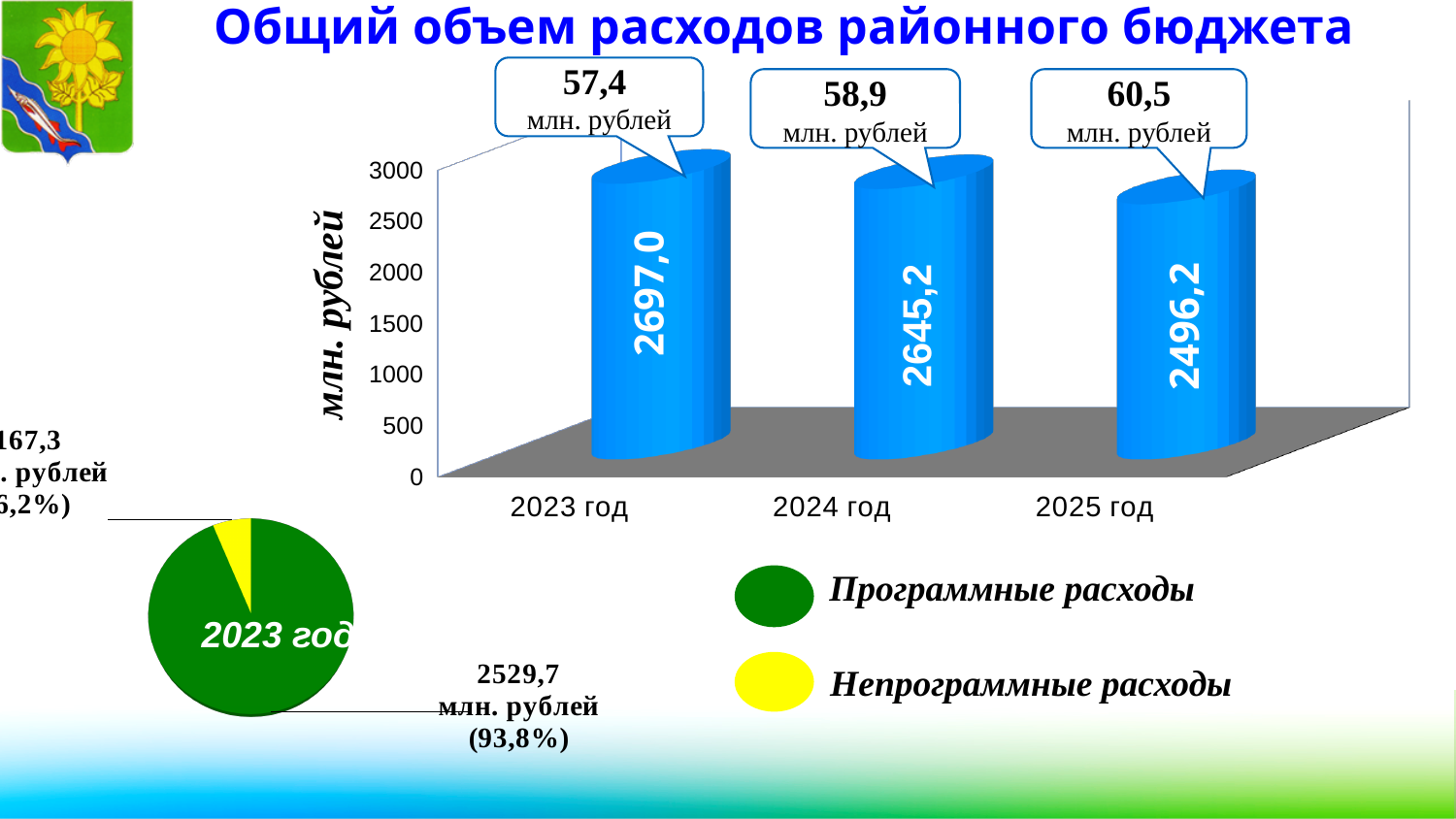
On the pie chart for 2023 год, what is the value for Программные расходы? 2529,7 млн. рублей On the bar chart, which year has the highest value? 2023 год On the bar chart, what is the value for 2024 год? 2645,2 On the bar chart, what is the value for 2025 год? 2496,2 On the bar chart, what is the value for 2023 год? 2697,0 On the bar chart, do the values rise or fall from 2023 год to 2025 год? fall What kind of chart is the chart with the years 2023, 2024 and 2025? bar chart On the bar chart, how many years are shown? 3 On the pie chart for 2023 год, what share do Программные расходы have? 93,8% On the bar chart, which year has the lowest value? 2025 год On the bar chart, what is the difference between the values for 2023 год and 2025 год? 200,8 On the bar chart, which is larger, the value for 2024 год or the value for 2025 год? 2024 год